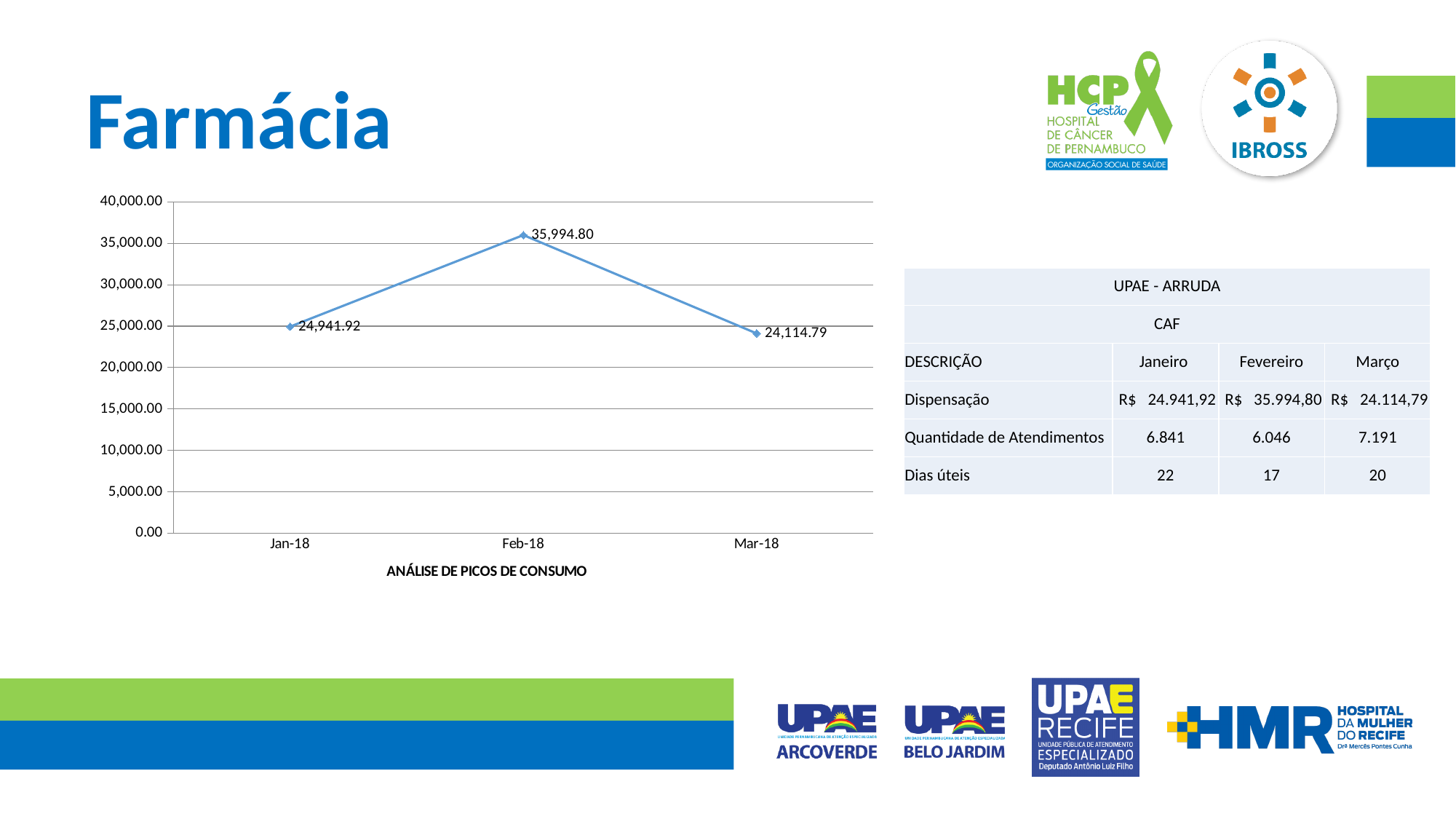
What is the title shown below the chart? ANÁLISE DE PICOS DE CONSUMO Is the value for Feb-18 greater or less than 35,000.00? greater Which is larger, the value for Jan-18 or the value for Mar-18? Jan-18 What is the value plotted for Mar-18? 24,114.79 Which month has the highest value on the chart? Feb-18 How many data points are plotted on the chart? 3 What is the value plotted for Feb-18? 35,994.80 What is the difference between the Feb-18 and Jan-18 values? 11,052.88 Which month has the lowest value on the chart? Mar-18 What kind of chart is shown on the slide? line chart What is the value plotted for Jan-18? 24,941.92 What is the difference between the Feb-18 and Mar-18 values? 11,880.01